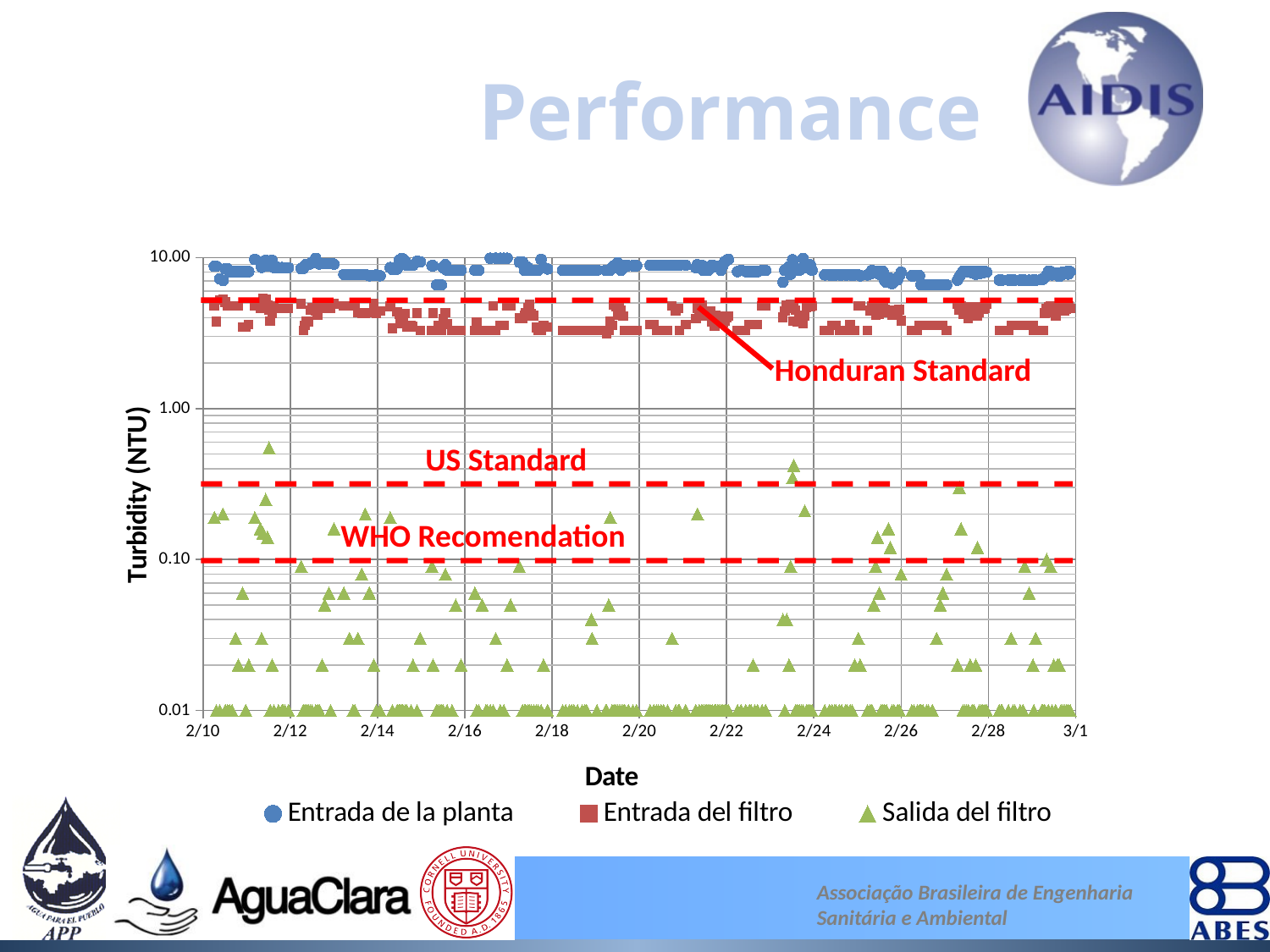
Which series has the highest turbidity values overall: Entrada de la planta or Salida del filtro? Entrada de la planta Which series has the lowest turbidity values overall? Salida del filtro Are the values for Entrada de la planta greater or less than 1.00 NTU? greater Are the values for Salida del filtro greater or less than 1.00 NTU? less What is the title of the slide containing the chart? Performance Are the values for Entrada del filtro greater or less than 1.00 NTU? greater How many series does the legend list? 3 Which series is plotted with green triangles? Salida del filtro Which dashed reference line is at the lowest turbidity level: Honduran Standard, US Standard, or WHO Recomendation? WHO Recomendation What kind of chart is shown on the slide? Scatter chart Which series has the highest turbidity values overall? Entrada de la planta What is the label of the y-axis? Turbidity (NTU)